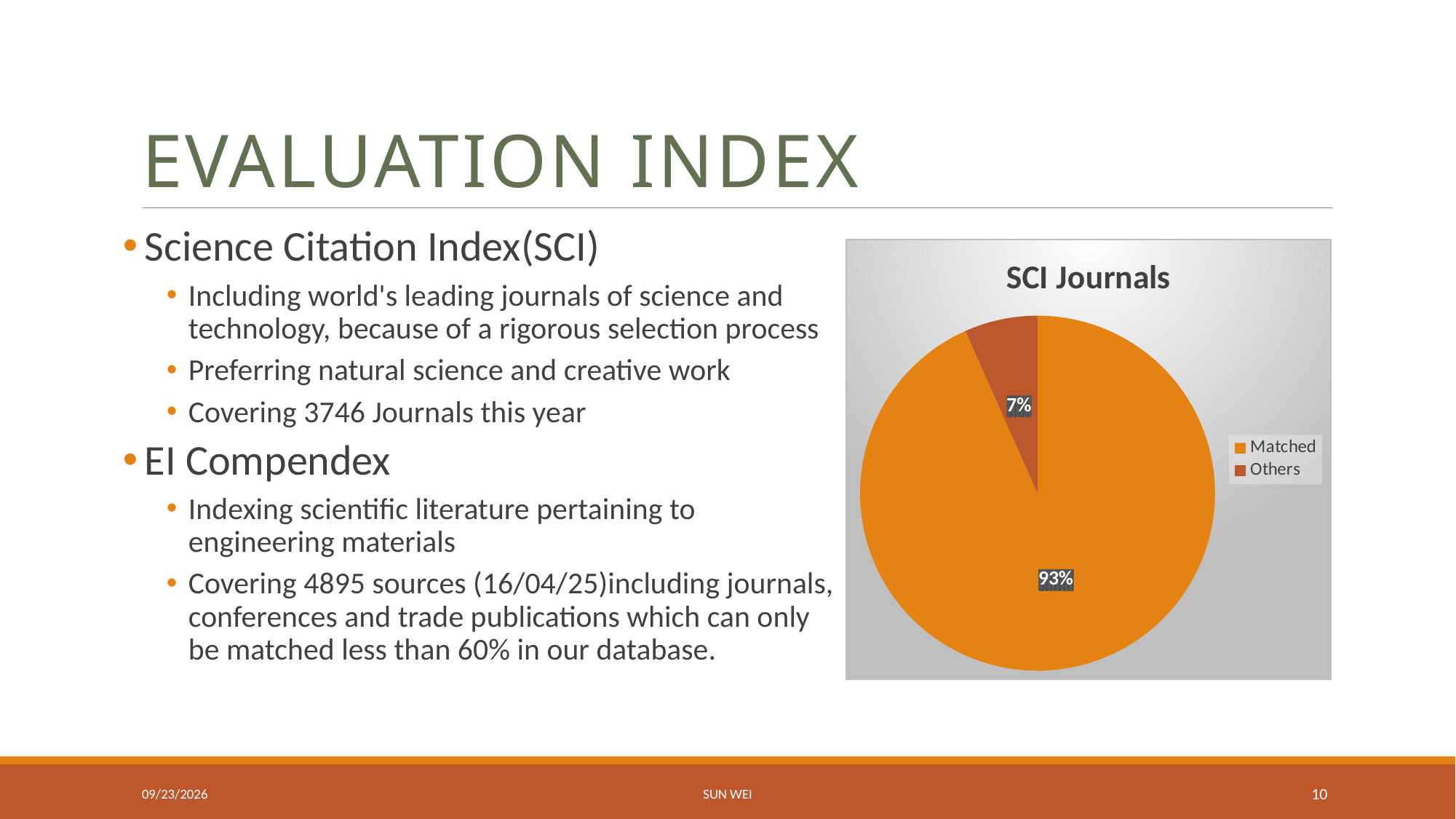
Which is larger, the Matched slice or the Others slice? Matched What is the difference in percentage points between the Matched and Others slices? 86 What colour is the Matched slice in the pie chart? orange How many entries does the legend list? 2 Which slice is the largest in the pie chart? Matched Which slice is the smallest in the pie chart? Others What share of the pie does the Matched slice represent? 93% What share of the pie does the Others slice represent? 7% How many slices does the pie chart have? 2 What is the title of the chart? SCI Journals What kind of chart is shown on the slide? pie chart